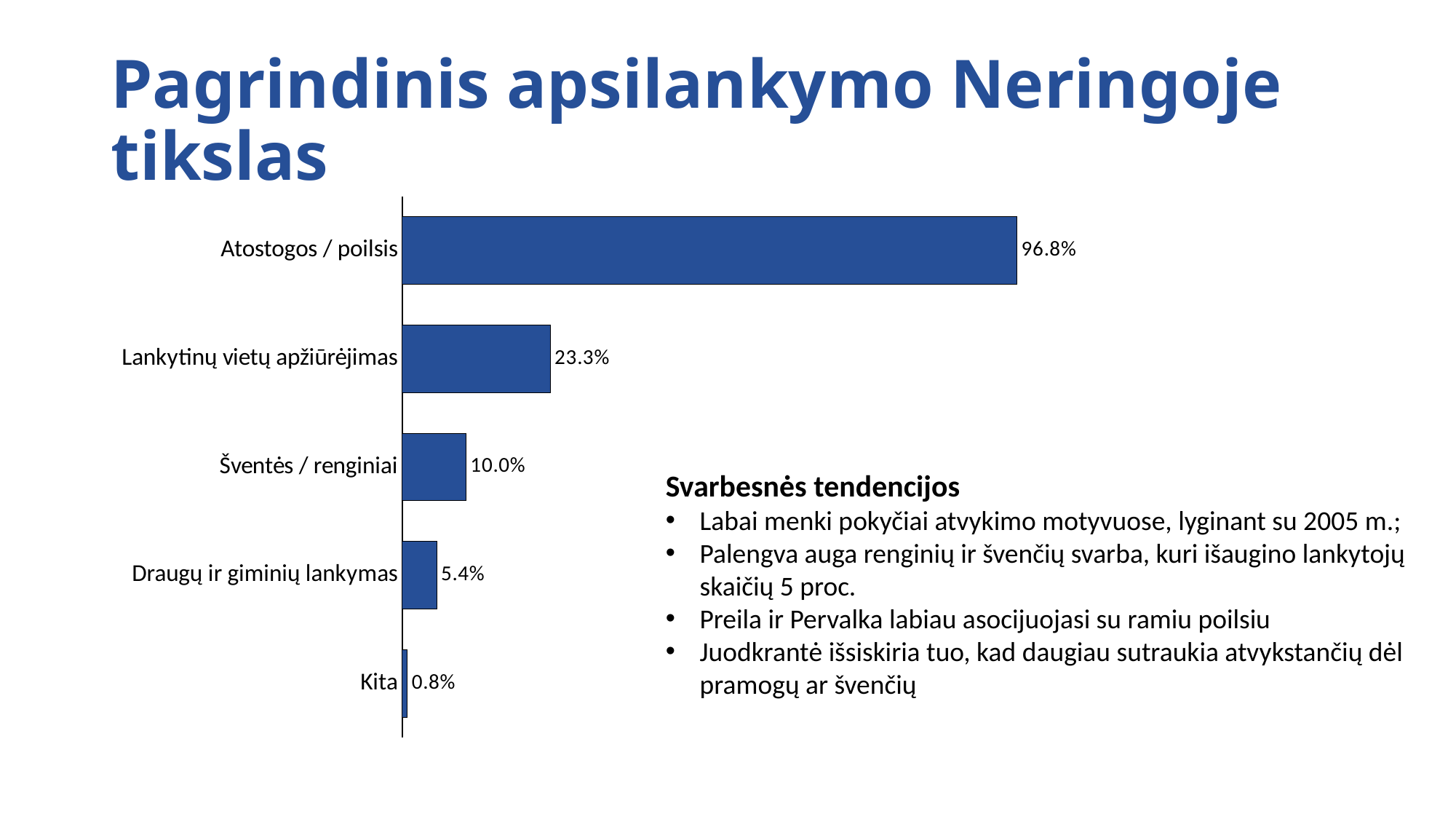
What kind of chart is shown on the slide? Bar chart What is the value for Draugų ir giminių lankymas? 5.4% What is the value for Lankytinų vietų apžiūrėjimas? 23.3% Which category has the lowest value? Kita What is the value for Šventės / renginiai? 10.0% Which is larger, the value for Šventės / renginiai or the value for Draugų ir giminių lankymas? Šventės / renginiai Which category has the highest value? Atostogos / poilsis What is the value for Kita? 0.8% What is the value for Atostogos / poilsis? 96.8% What is the difference between the values for Atostogos / poilsis and Lankytinų vietų apžiūrėjimas? 73.5% How many categories are shown in the chart? 5 What is the difference between the values for Šventės / renginiai and Draugų ir giminių lankymas? 4.6%